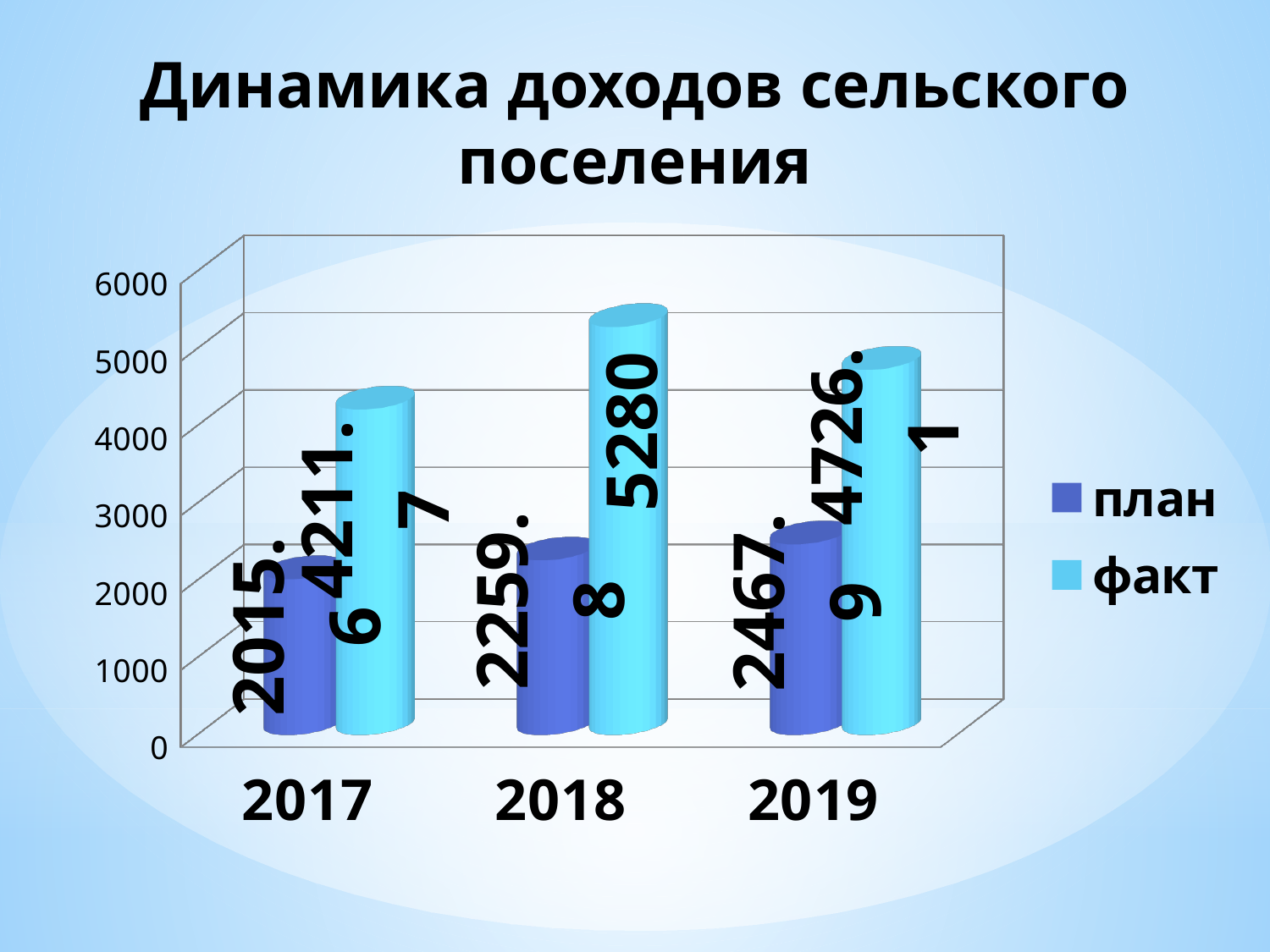
What is the difference between факт and план in 2018? 3020.2 Is the факт value for 2017 greater or less than 4000? greater In which year is the факт value highest? 2018 In which year is the план value lowest? 2017 What is the value of план for 2017? 2015.6 What is the value of факт for 2019? 4726.1 Which is larger in 2019: план or факт? факт How many years are shown on the x axis? 3 How many series does the legend list? 2 Does the план value rise or fall from 2017 to 2019? rise What is the value of план for 2019? 2467.9 What is the value of факт for 2018? 5280